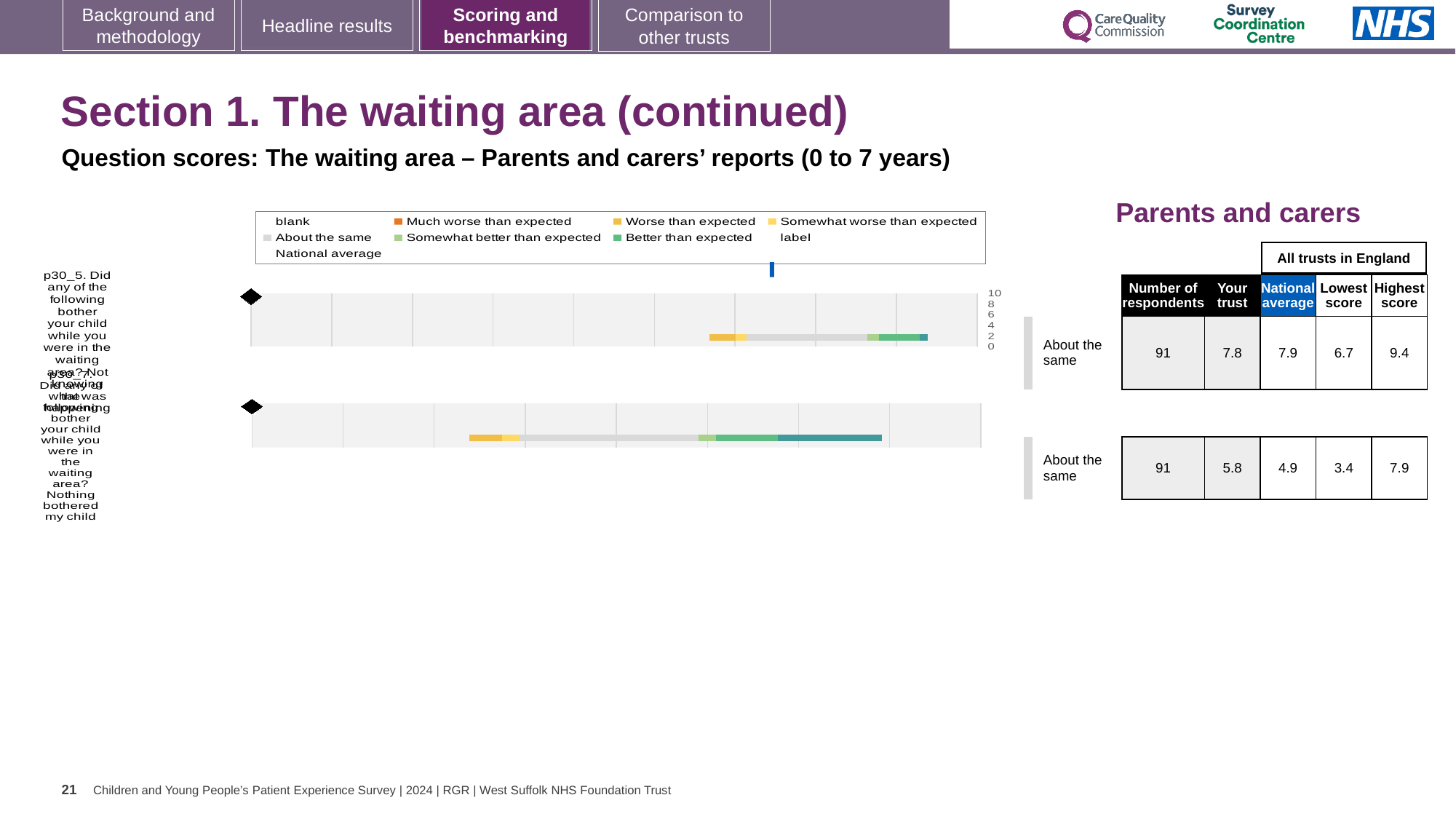
For the top chart (p30_5), what is the national average score shown in the table? 7.9 For the bottom chart (p30_7), is the trust's score larger or smaller than the national average? larger What kind of chart is used on this slide to show the question scores? bar chart For the bottom chart (p30_7), what is the highest score among all trusts in England shown in the table? 7.9 For the top chart (p30_5), what is the difference between the highest score and the lowest score among all trusts in England? 2.7 For the bottom chart (p30_7, Nothing bothered my child), what is the 'Your trust' score shown in the table beside it? 5.8 How many entries does the legend above the charts list? 9 How many separate bar charts are plotted on the slide? 2 For the bottom chart (p30_7), what is the difference between the trust's score and the national average? 0.9 What benchmark category label is shown next to both charts? About the same Which legend entry is shown in grey? About the same For the top chart (p30_5), what is the 'Your trust' score shown in the table beside it? 7.8